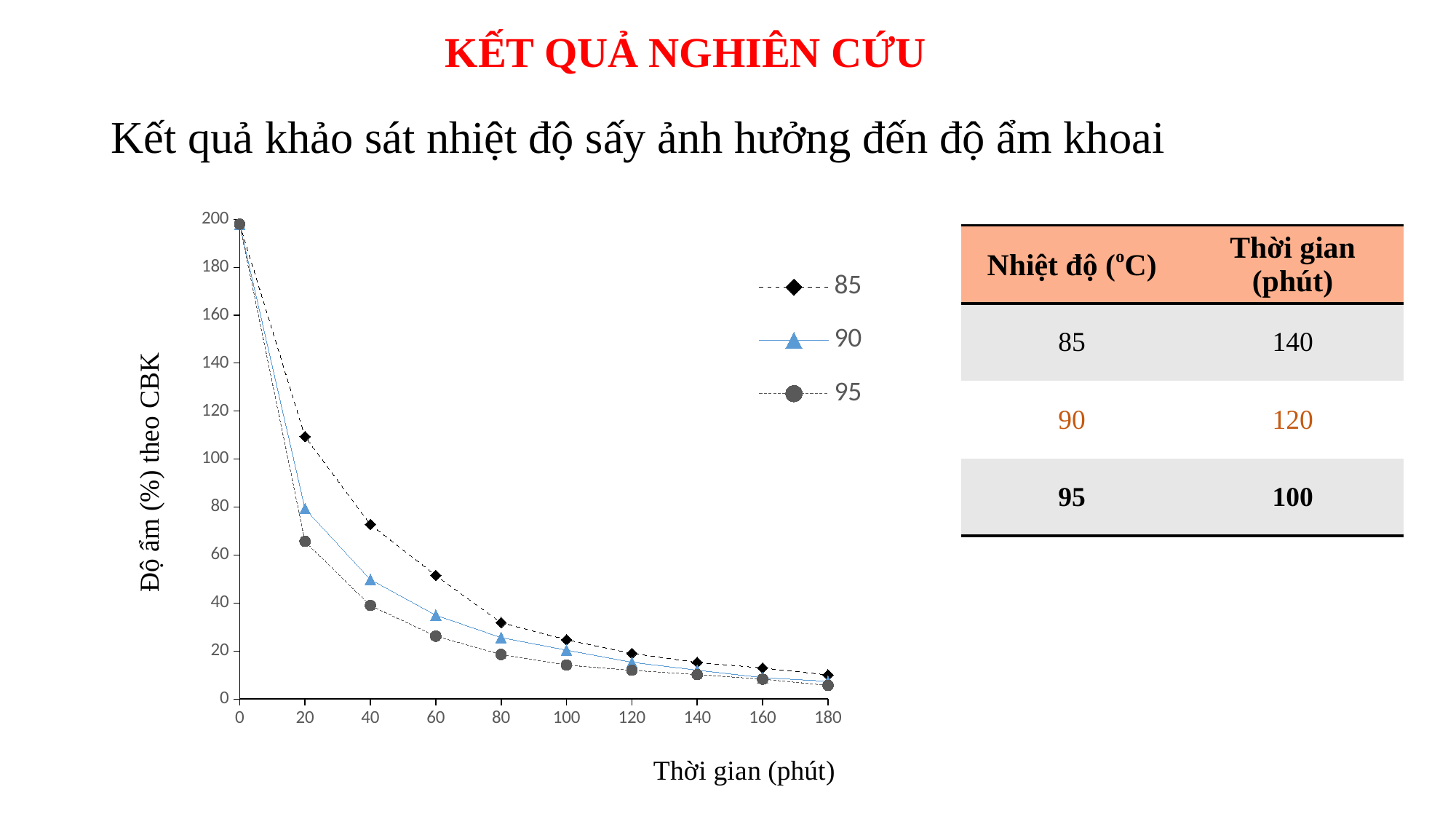
Is the value for series 85 at 20 minutes greater or less than 100? greater Is the value for series 95 at 20 minutes greater or less than 80? less At 40 minutes, which series has the larger value, 85 or 90? 85 How many series does the chart legend list? 3 Is the value for series 85 at 180 minutes greater or less than 20? less What kind of chart is shown on the slide? line chart Which series has the highest value at 20 minutes? 85 Do the values in the chart rise or fall as time increases along the x axis? fall Which series has the lowest value at 20 minutes? 95 How many time points are plotted for each series in the chart? 10 What is the title of the chart's x axis? Thời gian (phút)